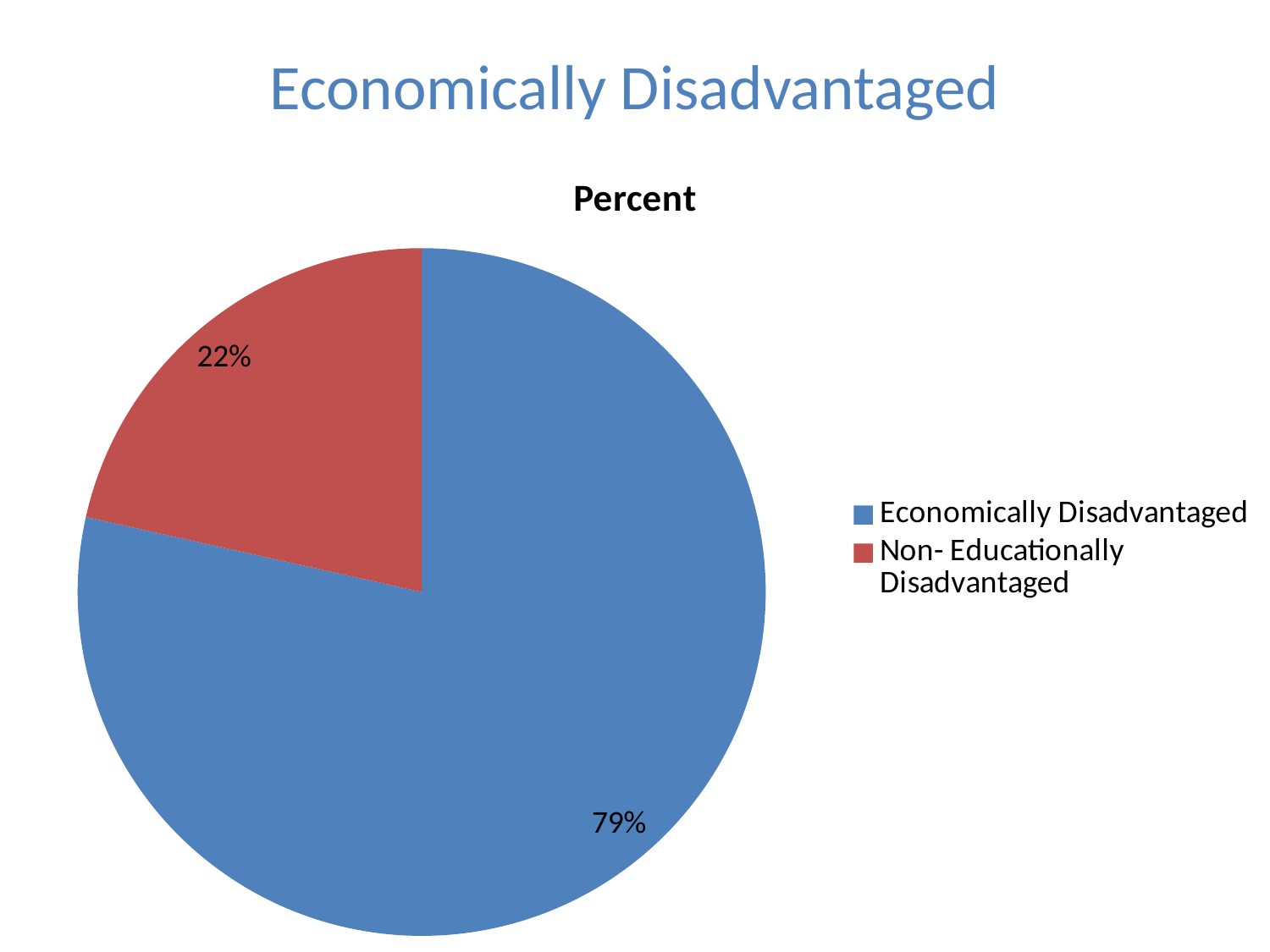
How many slices does the pie chart have? 2 How many entries does the legend list? 2 What percentage of the pie is labelled Non- Educationally Disadvantaged? 22% What colour is the Non- Educationally Disadvantaged slice? Red Which slice of the pie is the smallest? Non- Educationally Disadvantaged What is the difference in percentage points between the Economically Disadvantaged slice and the Non- Educationally Disadvantaged slice? 57 Which slice of the pie is the largest? Economically Disadvantaged What kind of chart is shown on the slide? Pie chart What percentage of the pie is labelled Economically Disadvantaged? 79% What is the title shown above the pie chart? Percent Which slice is larger, Economically Disadvantaged or Non- Educationally Disadvantaged? Economically Disadvantaged